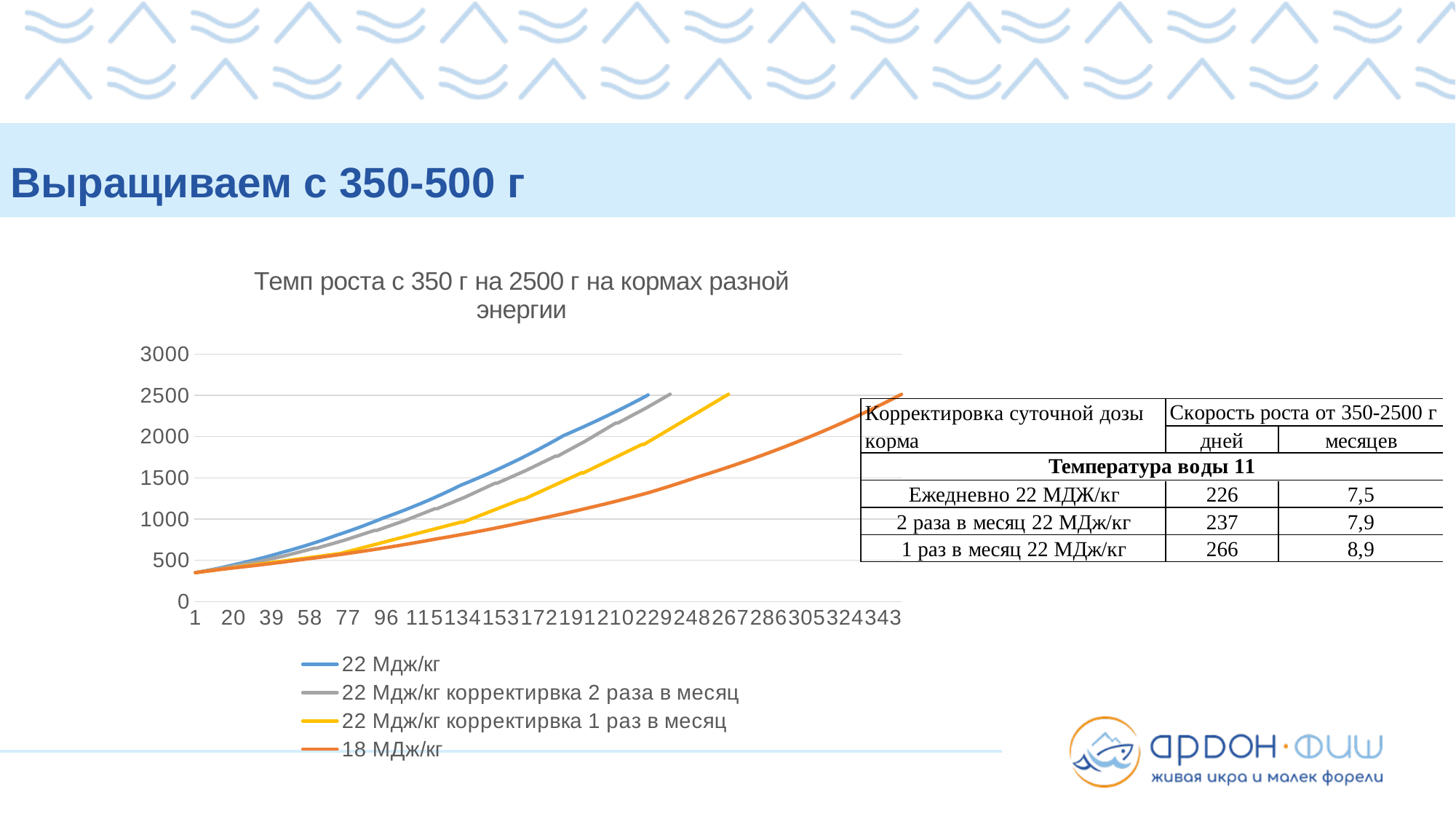
What is the highest value shown on the y axis of the chart? 3000 Which series reaches 2500 g at the earliest point on the x axis? 22 Мдж/кг Do the values of the 22 Мдж/кг series rise or fall along the x axis? rise At x = 210, is the value for the 22 Мдж/кг корректирвка 1 раз в месяц series greater or less than 1500? greater How many series does the chart legend list? 4 What kind of chart is shown on the slide? line chart At x = 115, is the value for the 22 Мдж/кг series greater or less than 1000? greater At x = 115, is the value for the 18 МДж/кг series greater or less than 1000? less What is the title of the chart? Темп роста с 350 г на 2500 г на кормах разной энергии Which series reaches 2500 g at the latest point on the x axis? 18 МДж/кг At x = 172, which series has the larger value: 22 Мдж/кг or 18 МДж/кг? 22 Мдж/кг Which series is drawn in orange in the chart? 18 МДж/кг